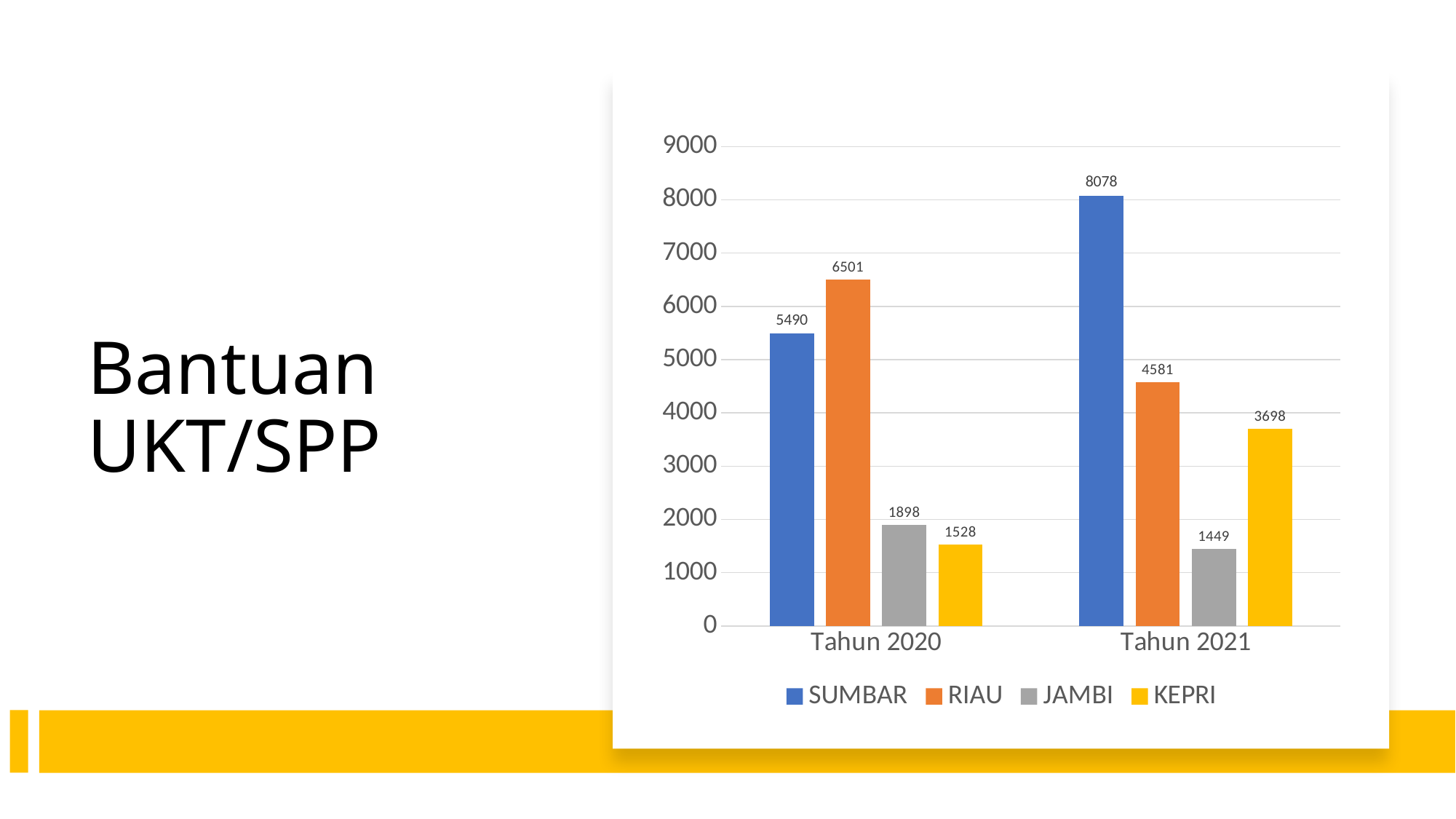
Is the value for KEPRI in Tahun 2020 greater or less than 2000? less How many series does the legend list? 4 Which series has the lowest value in Tahun 2021? JAMBI What is the difference between the SUMBAR values for Tahun 2021 and Tahun 2020? 2588 What kind of chart is shown on the slide? bar chart What is the value for SUMBAR in Tahun 2020? 5490 What is the value for KEPRI in Tahun 2021? 3698 What colour represents KEPRI in the chart? yellow What is the value for JAMBI in Tahun 2021? 1449 Which series has the highest value in Tahun 2020? RIAU How many categories are shown on the x axis? 2 Which is larger: RIAU in Tahun 2020 or RIAU in Tahun 2021? RIAU in Tahun 2020